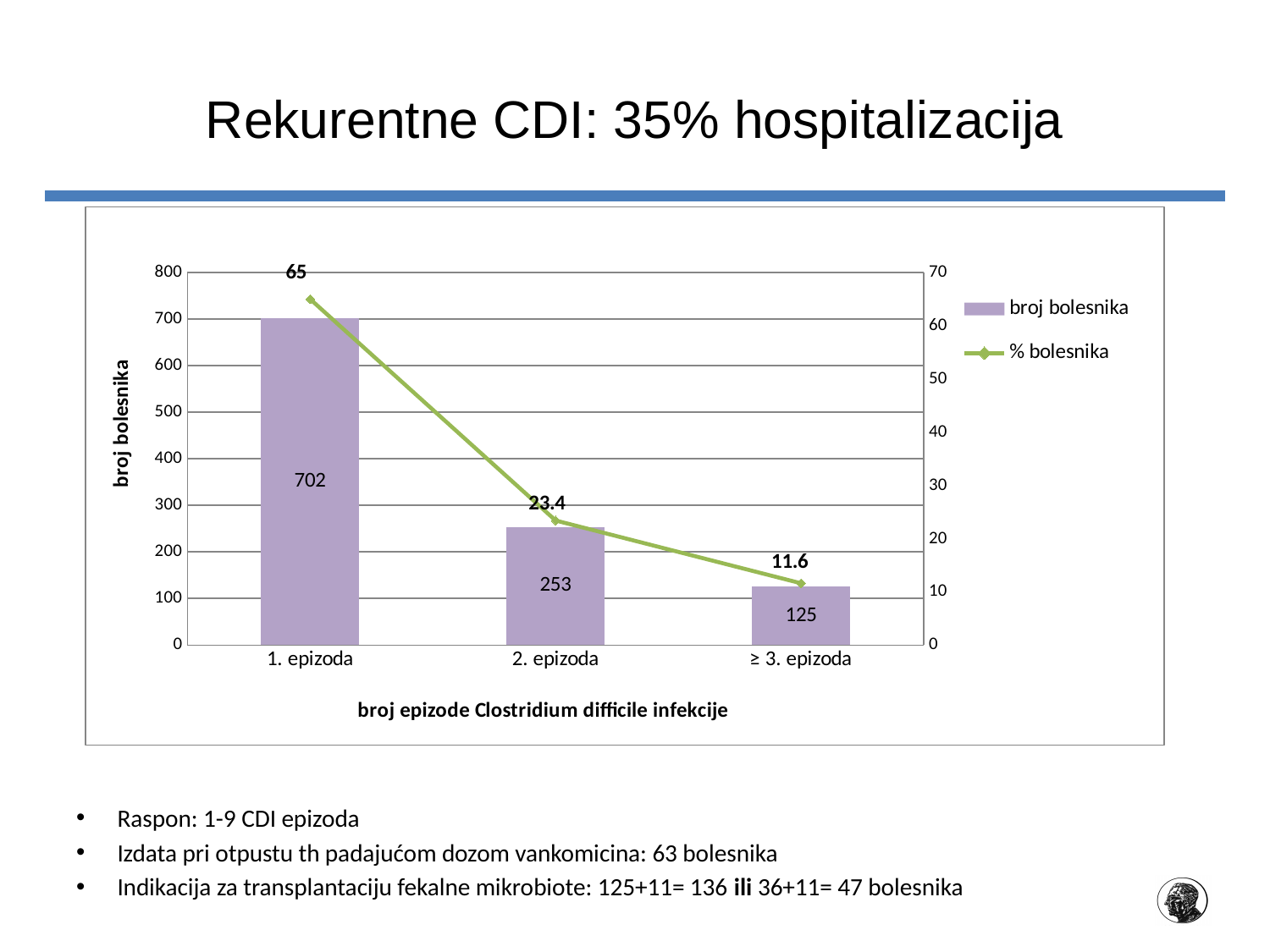
Which episode category has the lowest number of patients? ≥ 3. epizoda Which has more patients, 2. epizoda or ≥ 3. epizoda? 2. epizoda What is the difference in number of patients between 1. epizoda and 2. epizoda? 449 Which episode category has the highest number of patients? 1. epizoda What is the % bolesnika value for ≥ 3. epizoda? 11.6 How many series does the legend list? 2 Does the % bolesnika line rise or fall from 1. epizoda to ≥ 3. epizoda? fall What is the number of patients (broj bolesnika) for ≥ 3. epizoda? 125 What is the % bolesnika value for 2. epizoda? 23.4 What is the number of patients (broj bolesnika) for 1. epizoda? 702 How many episode categories are shown on the x axis? 3 What is the number of patients (broj bolesnika) for 2. epizoda? 253